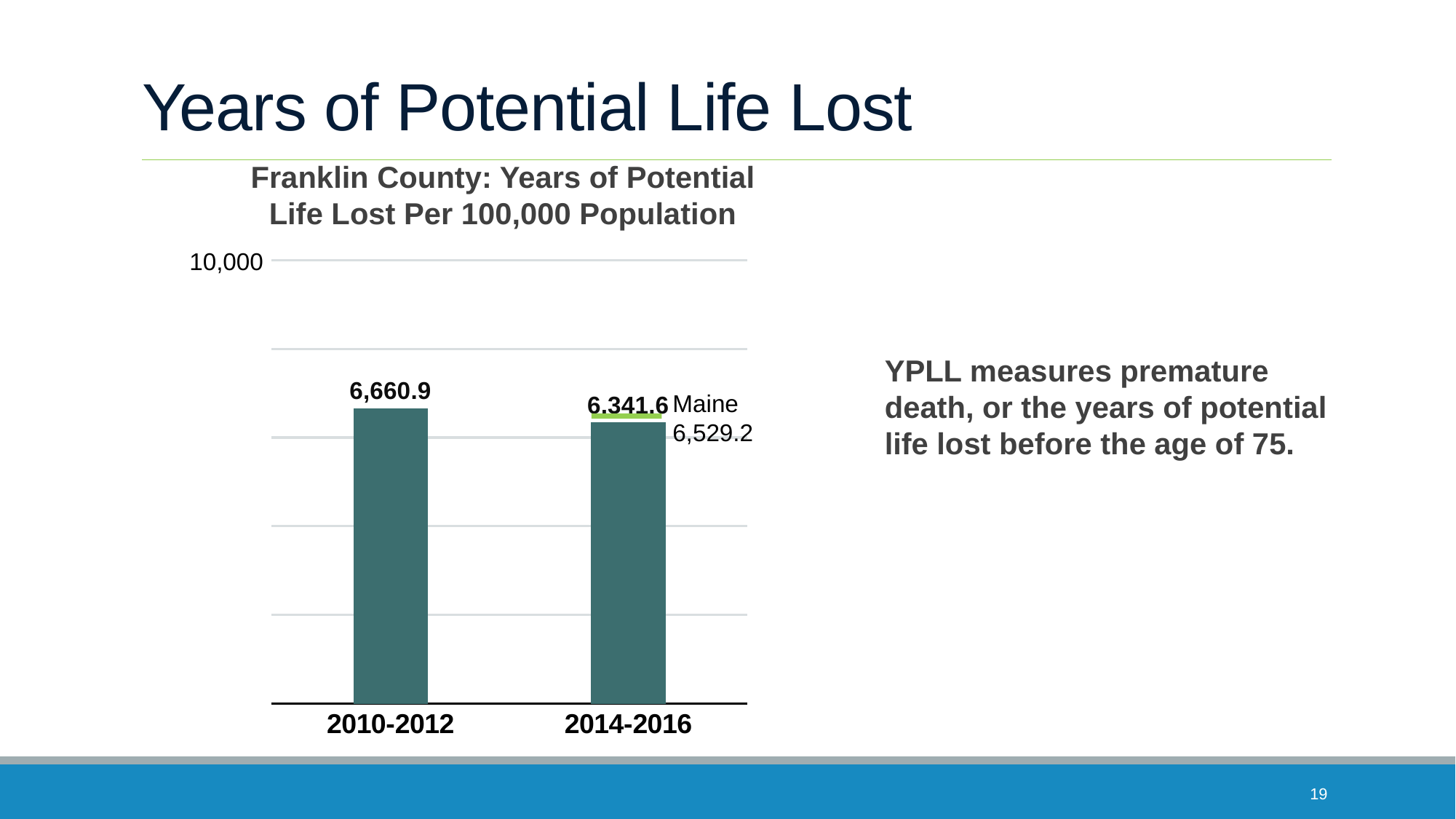
For 2014-2016, how much higher is the Maine value than the Franklin County value? 187.6 Is the Franklin County value for 2010-2012 greater or less than 10,000? less How many time periods are shown on the x axis? 2 What is the difference between the Franklin County values for 2010-2012 and 2014-2016? 319.3 Do the Franklin County values rise or fall from 2010-2012 to 2014-2016? fall What is the Franklin County value for 2014-2016? 6,341.6 What is the Maine value shown for 2014-2016? 6,529.2 Which period has the higher Franklin County value? 2010-2012 What kind of chart is shown on the slide? bar chart Which period has the lower Franklin County value? 2014-2016 For 2014-2016, which is larger: the Franklin County value or the Maine value? Maine What is the Franklin County value for 2010-2012? 6,660.9